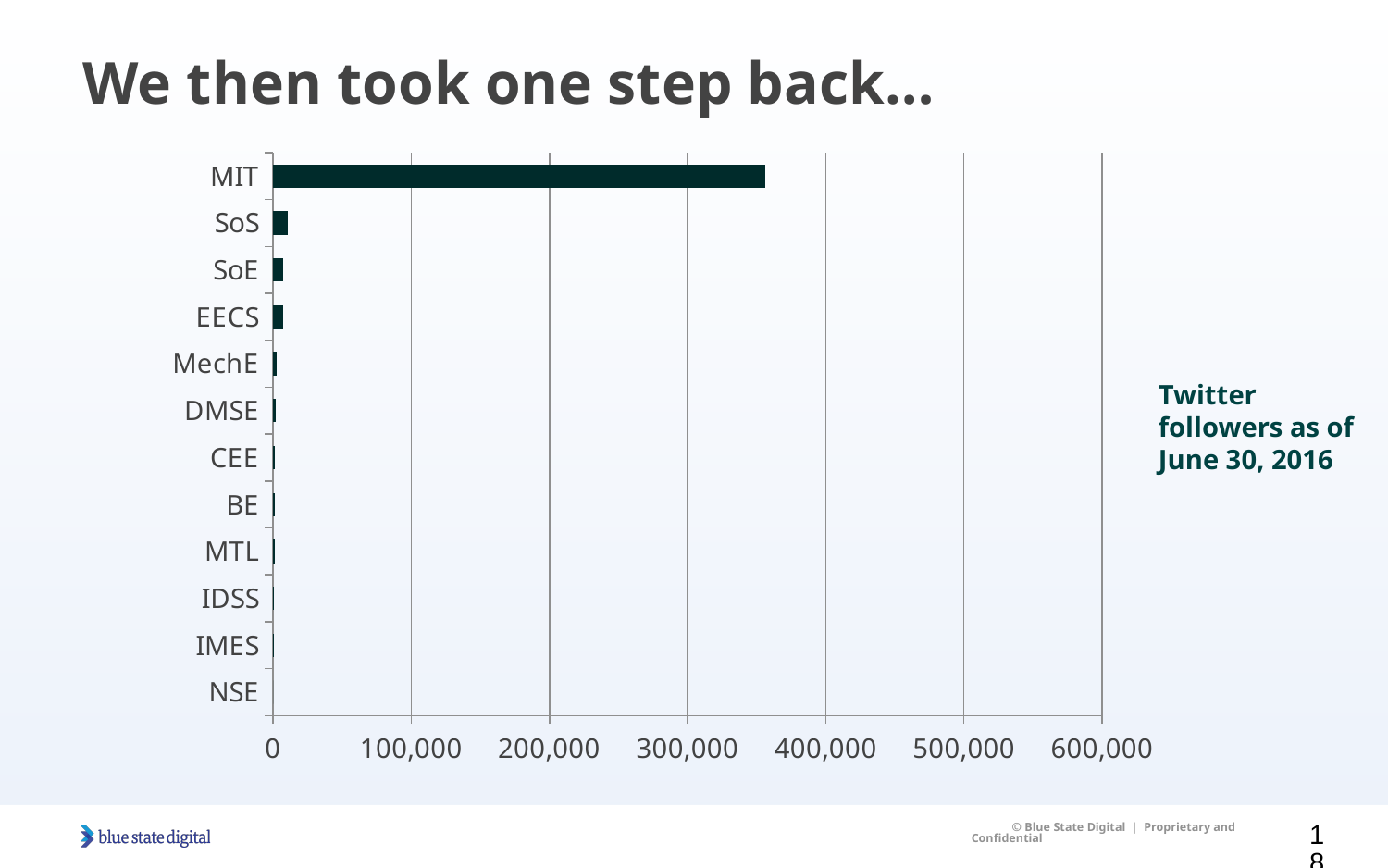
Which has a larger value, EECS or MTL? EECS Which has a larger value, MIT or SoS? MIT How many categories are plotted on the chart? 12 Which category is listed at the top of the chart? MIT What kind of chart is shown on the slide? bar chart Is the value for MIT greater or less than 400,000? less Is the value for MIT greater or less than 300,000? greater Which has a larger value, SoS or MechE? SoS According to the text beside the chart, what do the bars measure? Twitter followers as of June 30, 2016 Is the value for SoS greater or less than 100,000? less Which category has the highest value on the chart? MIT What is the highest value labelled on the horizontal axis? 600,000